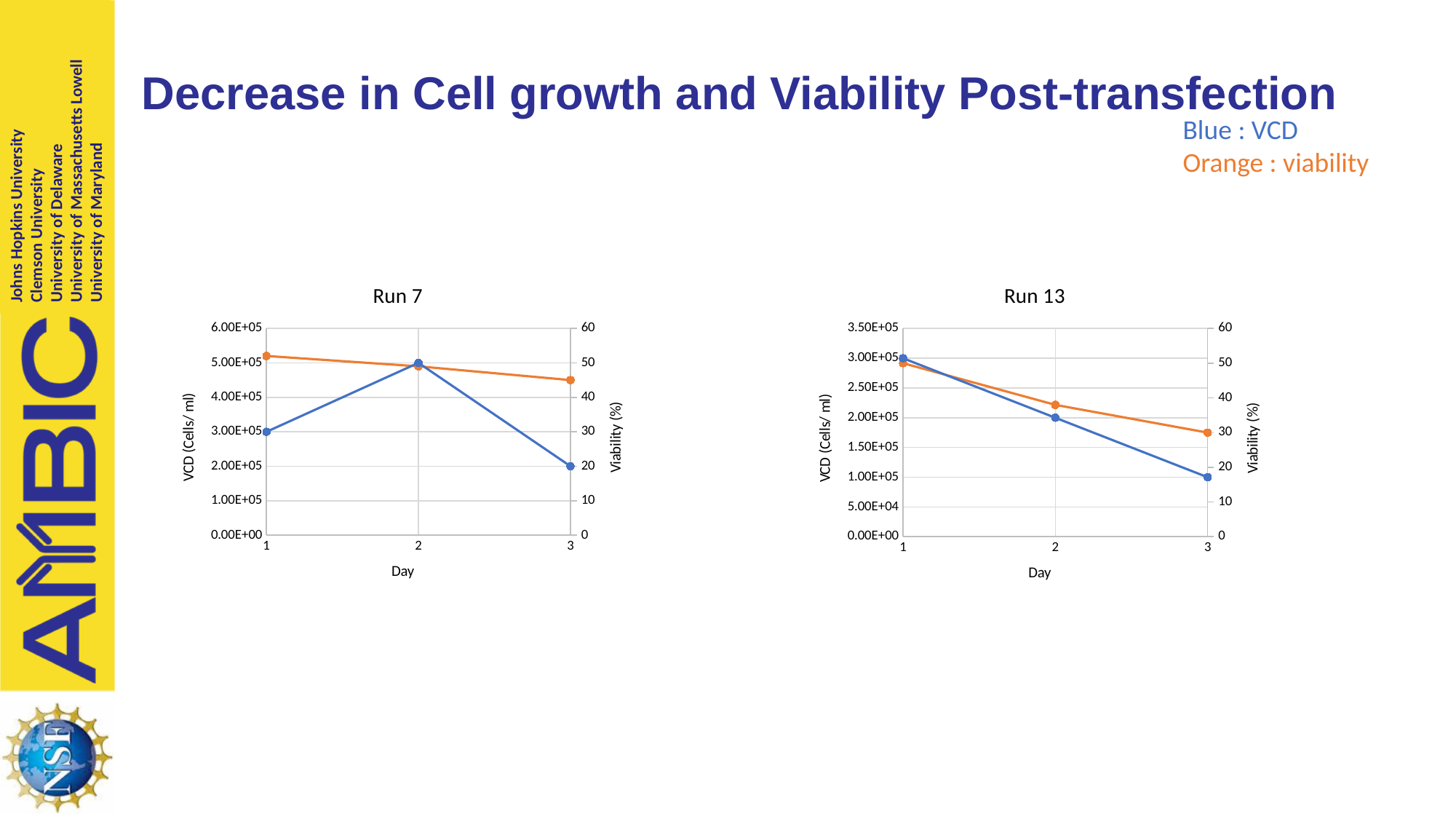
In the Run 7 chart, what is the VCD value on day 2? 5.00E+05 In the Run 13 chart, what is the VCD value on day 1? 3.00E+05 How many days are plotted on the x axis of the Run 13 chart? 3 In the Run 7 chart, what is the difference between the VCD on day 2 and the VCD on day 3? 3.00E+05 What kind of chart is the Run 7 chart? line chart In the Run 13 chart, does VCD rise or fall from day 1 to day 3? fall In the Run 7 chart, on which day is VCD highest? 2 According to the slide, which quantity does the orange line represent? viability In the Run 13 chart, is the viability on day 2 greater or less than 40? less In the Run 7 chart, what is the VCD value on day 3? 2.00E+05 In the Run 13 chart, what is the VCD value on day 3? 1.00E+05 In the Run 7 chart, is the viability on day 1 greater or less than 50? greater